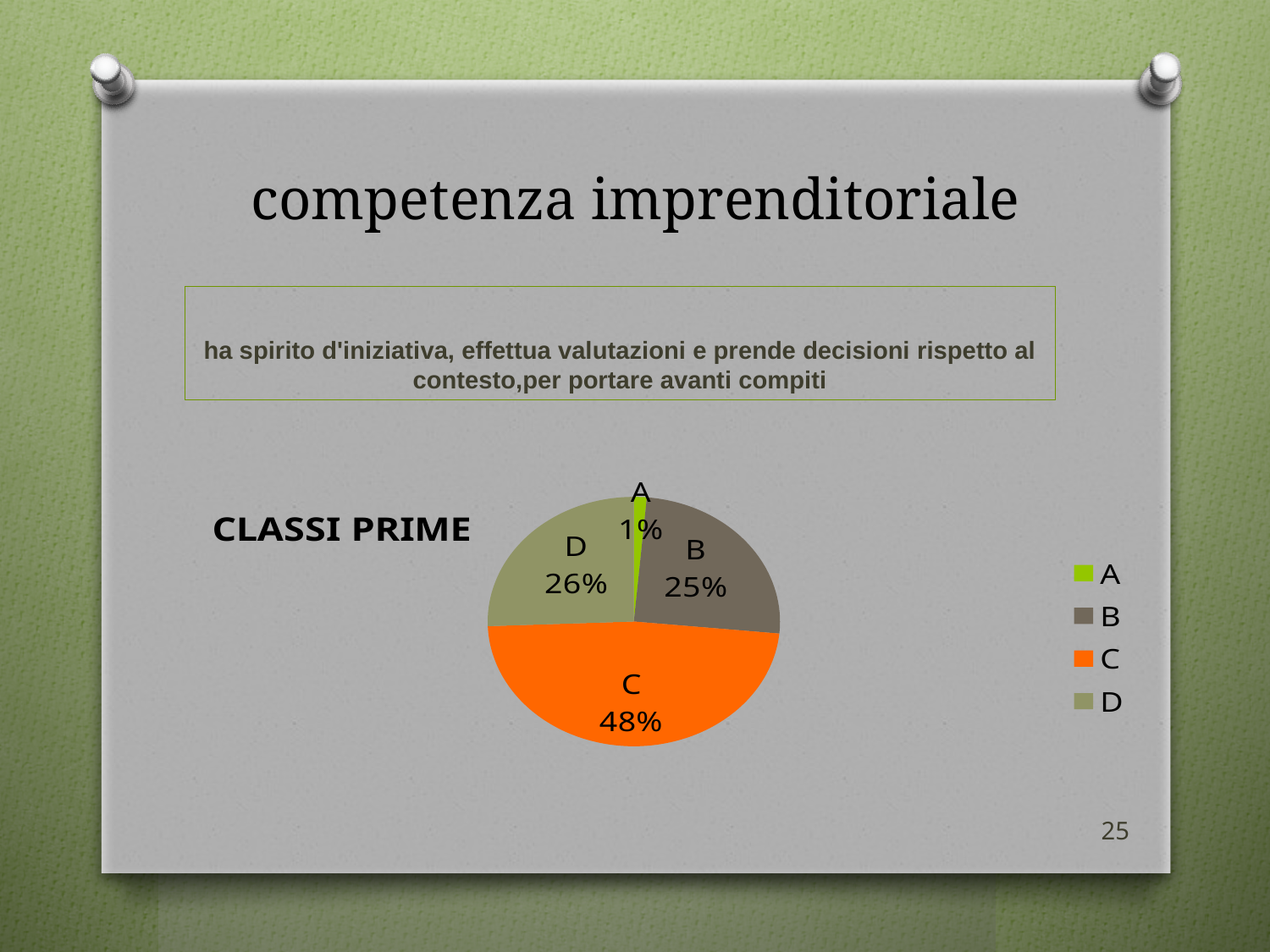
What percentage does slice C represent? 48% What percentage does slice D represent? 26% What percentage does slice A represent? 1% What percentage does slice B represent? 25% What colour is slice C in the pie chart? orange Which is larger, slice C or slice B? C Which category has the smallest share of the pie? A How many slices does the pie chart have? 4 What kind of chart is shown on the slide? pie chart What is the difference in percentage points between slice C and slice D? 22 How many entries does the legend list? 4 Which category has the largest share of the pie? C